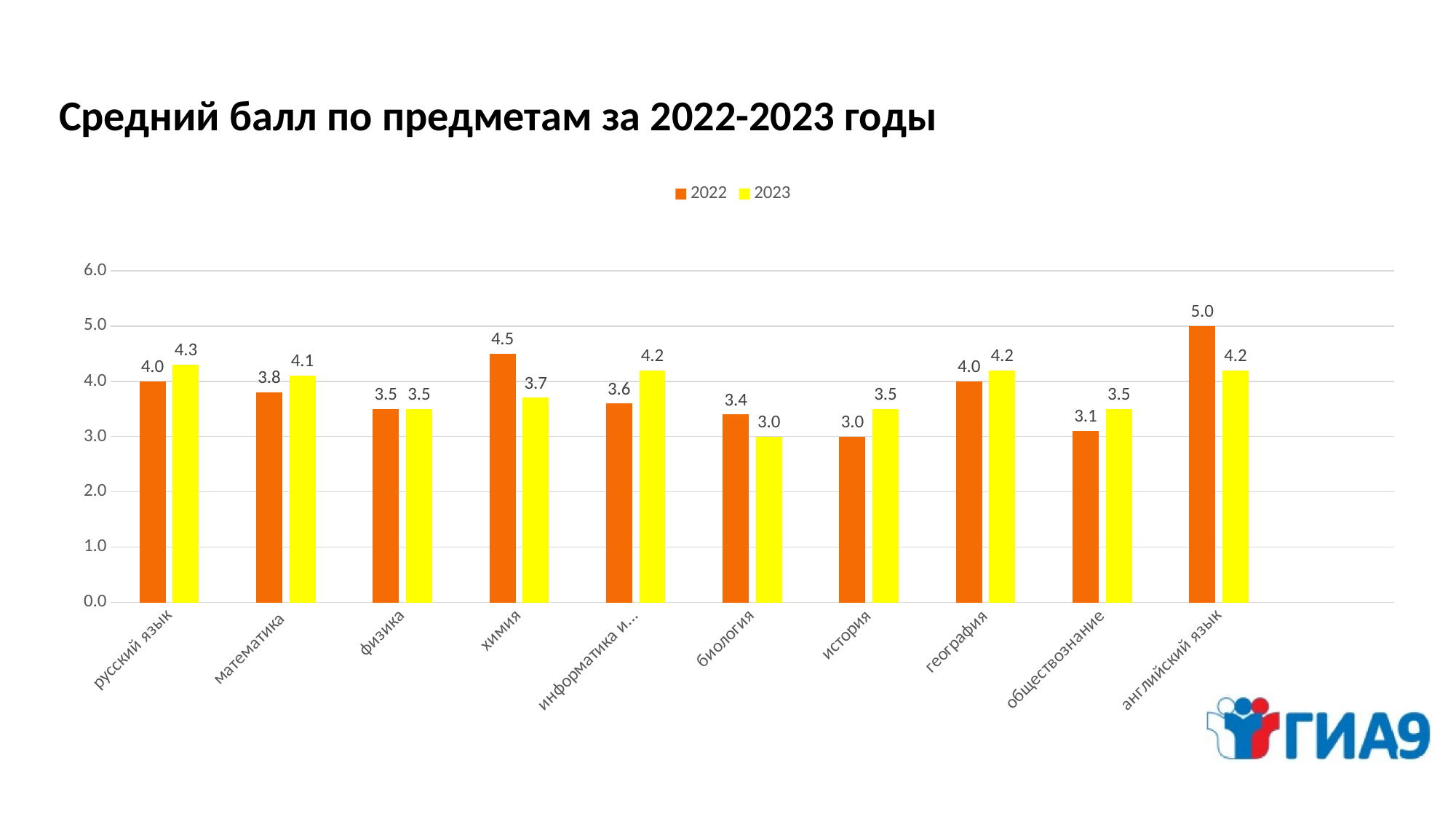
How many subjects are shown on the x axis? 10 How many series does the legend list? 2 Which subject has the lowest 2023 value? биология What is the 2022 value for русский язык? 4.0 Is the 2022 value for обществознание greater or less than 4.0? less Which is larger for история: the 2022 value or the 2023 value? 2023 What is the 2022 value for химия? 4.5 What kind of chart is shown on the slide? bar chart What is the title of the chart? Средний балл по предметам за 2022-2023 годы What is the 2023 value for математика? 4.1 What is the difference between the 2022 and 2023 values for английский язык? 0.8 Which subject has the highest 2022 value? английский язык